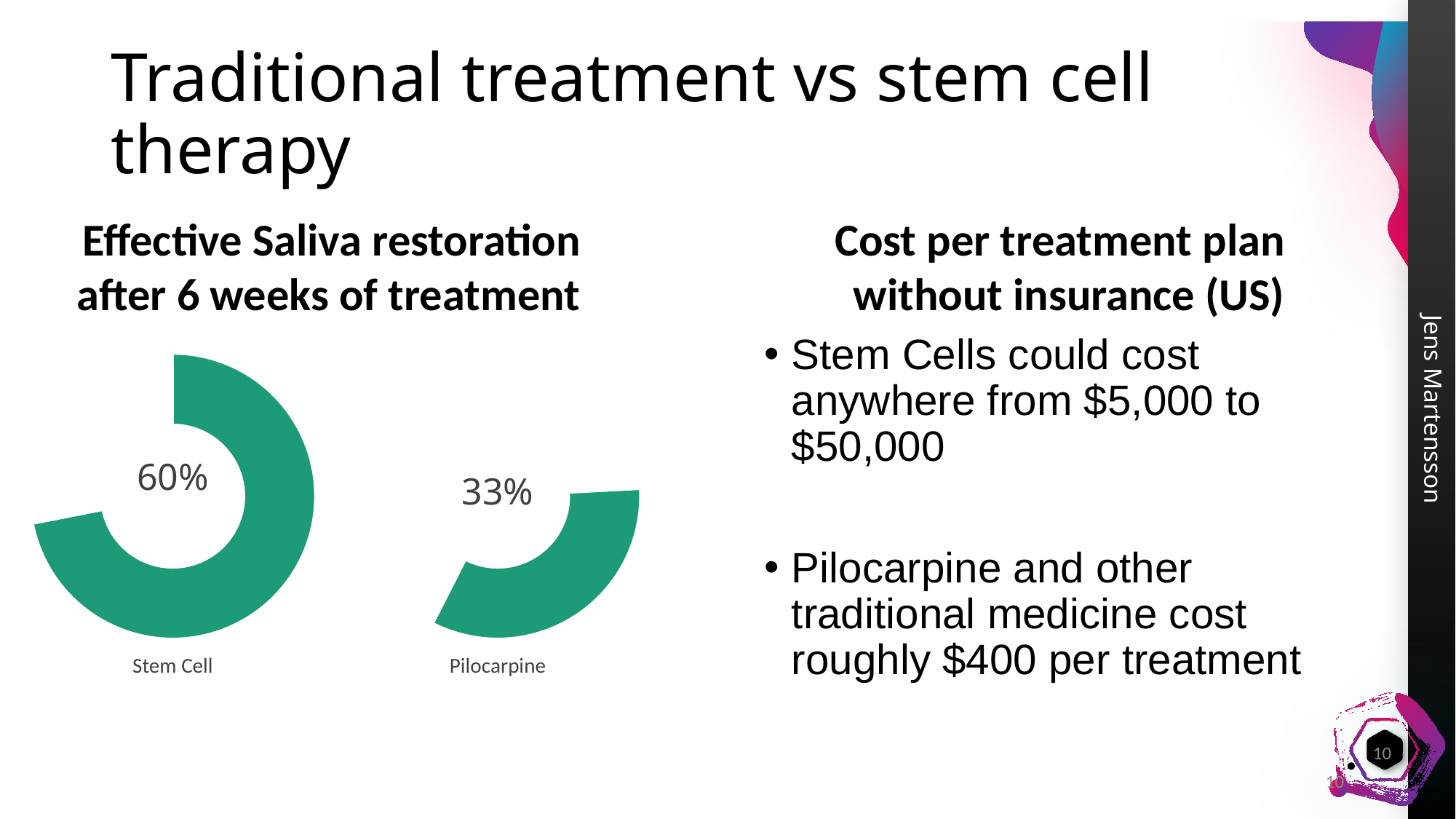
How many treatments are shown in the 'Effective Saliva restoration after 6 weeks of treatment' chart? 2 In the 'Effective Saliva restoration after 6 weeks of treatment' chart, which treatment has the lower saliva restoration value? Pilocarpine In the 'Effective Saliva restoration after 6 weeks of treatment' chart, what is the value shown for Pilocarpine? 33% In the 'Effective Saliva restoration after 6 weeks of treatment' chart, which treatment has the higher saliva restoration value? Stem Cell What colour are the rings in the 'Effective Saliva restoration after 6 weeks of treatment' chart? Green What is the title of the chart on the left side of the slide? Effective Saliva restoration after 6 weeks of treatment What kind of chart is used to show 'Effective Saliva restoration after 6 weeks of treatment'? Doughnut chart In the 'Effective Saliva restoration after 6 weeks of treatment' chart, what is the value shown for Stem Cell? 60% In the 'Effective Saliva restoration after 6 weeks of treatment' chart, what is the difference between the Stem Cell and Pilocarpine values? 27% In the 'Effective Saliva restoration after 6 weeks of treatment' chart, is the value for Stem Cell larger or smaller than the value for Pilocarpine? larger